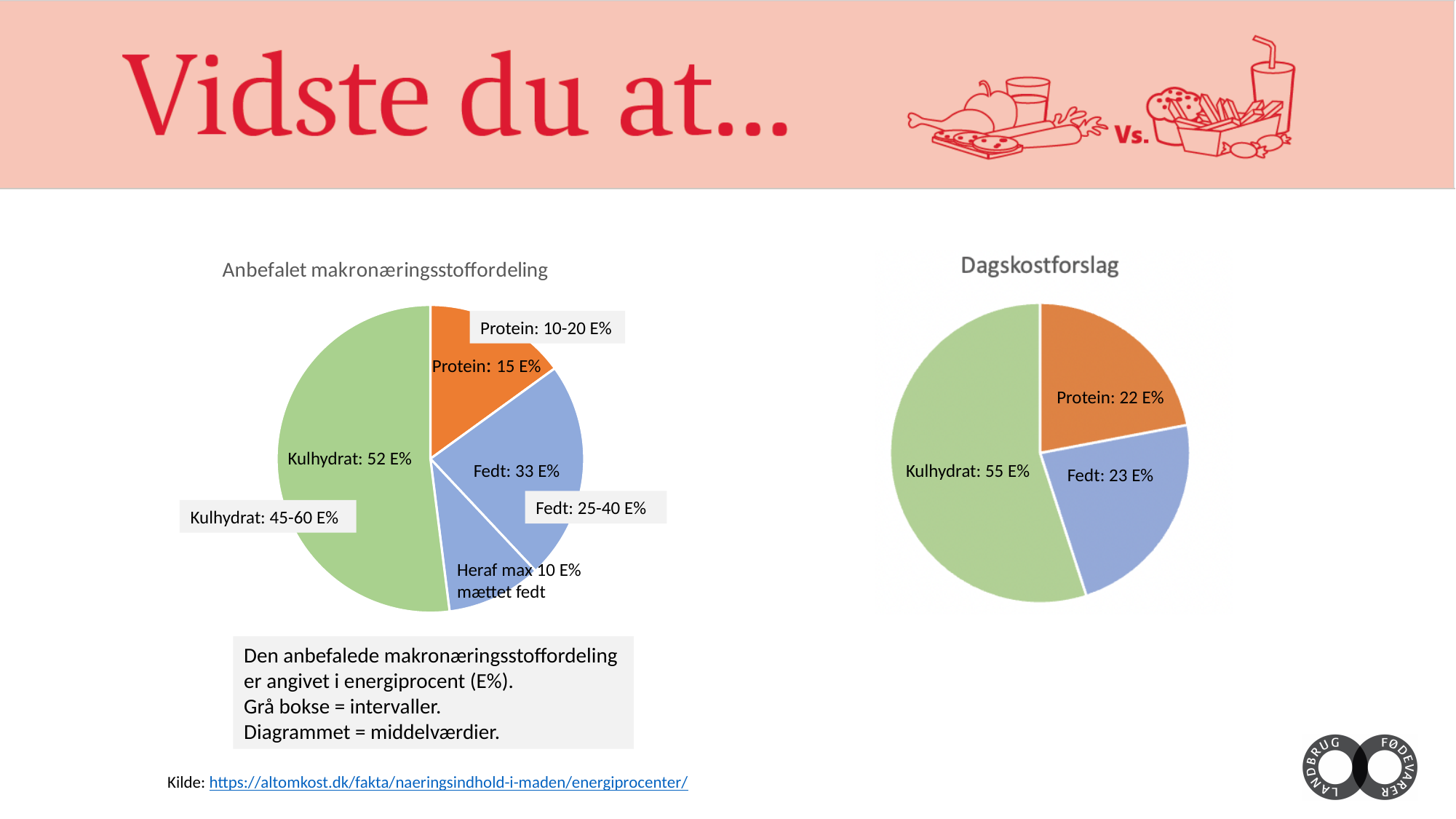
In the 'Anbefalet makronæringsstoffordeling' chart, which of the three main categories has the smallest share? Protein In the 'Dagskostforslag' chart, what is the value for Protein? 22 E% In the 'Anbefalet makronæringsstoffordeling' chart, what is the value for Protein? 15 E% What is the difference between the Kulhydrat value in the 'Dagskostforslag' chart and the Kulhydrat value in the 'Anbefalet makronæringsstoffordeling' chart? 3 E% In the 'Anbefalet makronæringsstoffordeling' chart, what is the value for Fedt? 33 E% In the 'Dagskostforslag' chart, which category has the largest share? Kulhydrat In the 'Anbefalet makronæringsstoffordeling' chart, what is the value for Kulhydrat? 52 E% In the 'Dagskostforslag' chart, which is larger, Fedt or Protein? Fedt In the 'Anbefalet makronæringsstoffordeling' chart, what interval is given in the grey box for Fedt? 25-40 E% In the 'Dagskostforslag' chart, what is the value for Kulhydrat? 55 E% What type of chart is the 'Dagskostforslag' chart? Pie chart How many categories are shown in the 'Dagskostforslag' chart? 3